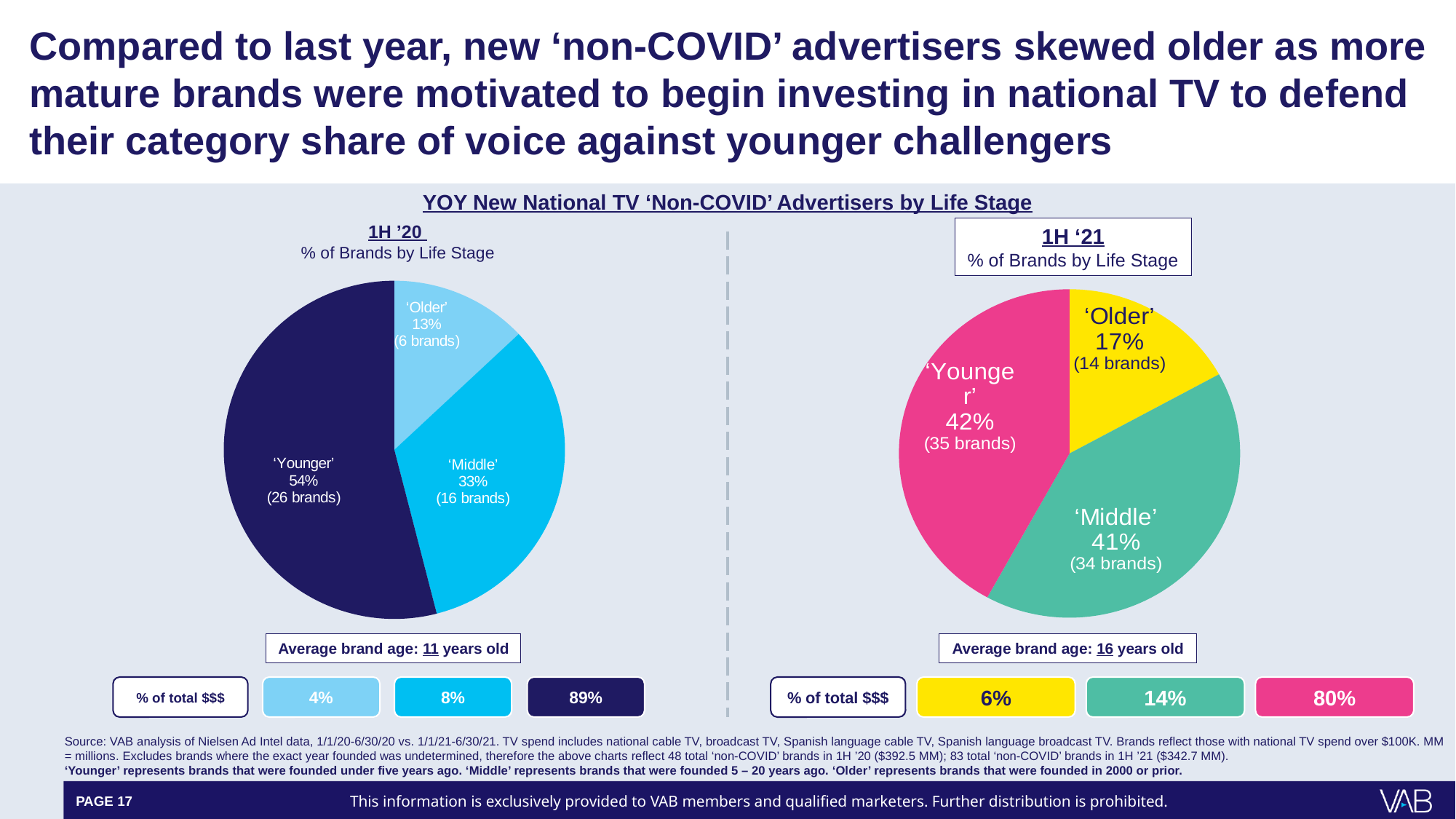
In the 1H '20 pie chart, which life stage has the smallest share of brands? 'Older' What is the difference in the 'Older' share of brands between the 1H '21 pie chart and the 1H '20 pie chart? 4 percentage points In the 1H '21 pie chart, how many brands are in the 'Younger' life stage? 35 brands In the 1H '20 pie chart, which life stage has the largest share of brands? 'Younger' How many life stage slices does each pie chart contain? 3 In the 1H '21 pie chart, what is the difference between the 'Younger' and 'Middle' shares? 1 percentage point In the 1H '21 pie chart, which life stage has the smallest share of brands? 'Older' In the 1H '20 pie chart, how many brands are in the 'Middle' life stage? 16 brands In the 1H '21 pie chart, what percentage of brands are 'Older'? 17% What is the title shown above the two pie charts? YOY New National TV 'Non-COVID' Advertisers by Life Stage In the 1H '20 pie chart, what percentage of brands are 'Younger'? 54% What type of chart is used for the 1H '20 % of Brands by Life Stage? Pie chart